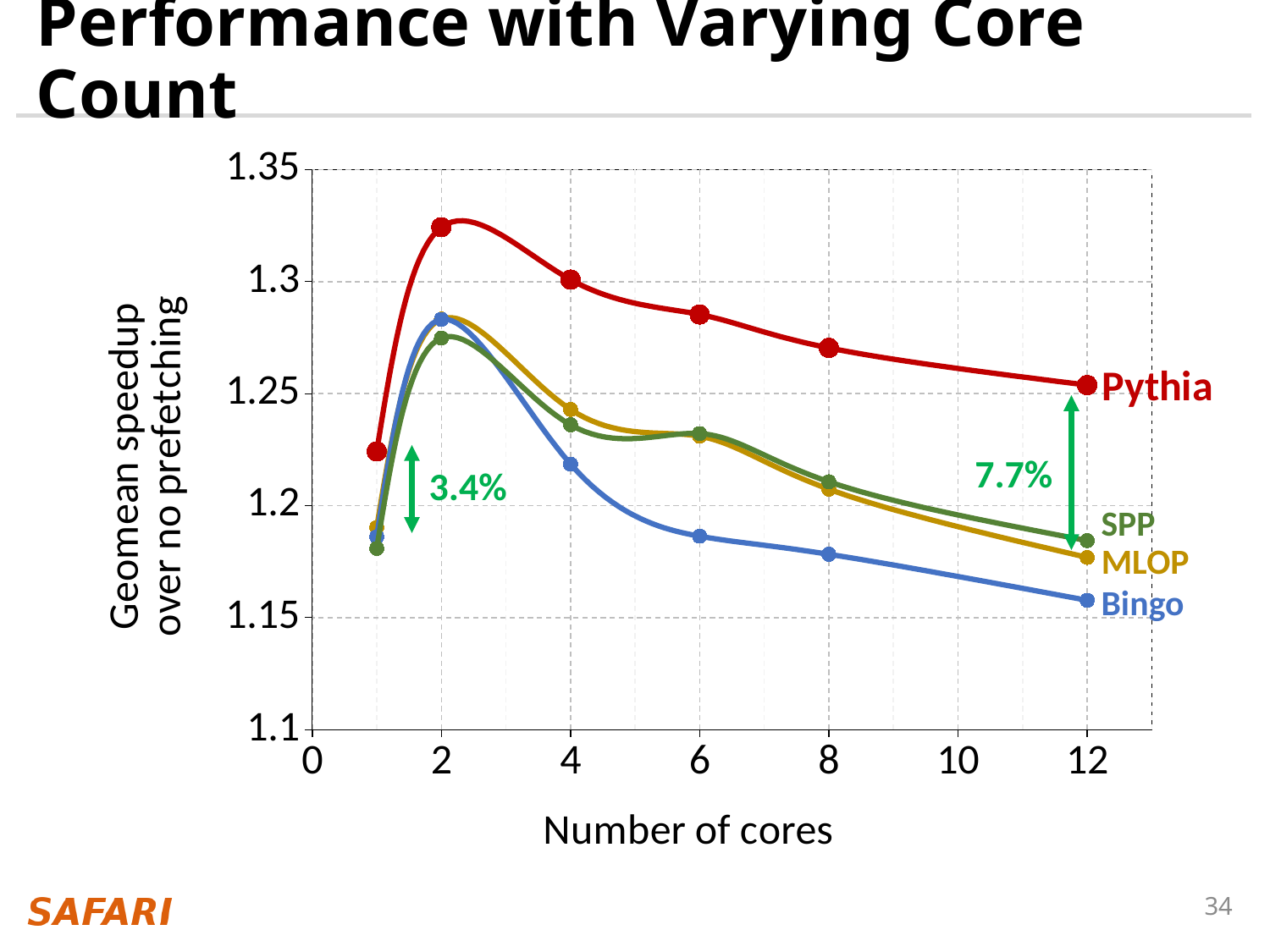
Is the geomean speedup for SPP at 2 cores greater or less than 1.25? greater Which prefetcher has the highest geomean speedup at 12 cores? Pythia How many series (prefetchers) are plotted in the chart? 4 Which prefetcher has the lowest geomean speedup at 12 cores? Bingo Which prefetcher has the lowest geomean speedup at 4 cores? Bingo Is the geomean speedup for Bingo at 12 cores greater or less than 1.2? less Is the geomean speedup for Pythia at 2 cores greater or less than 1.3? greater What kind of chart is shown on the slide? line chart At 8 cores, which has the higher geomean speedup, Pythia or MLOP? Pythia What is the label of the x axis? Number of cores How many data points does the Pythia line have? 6 Does the Pythia line rise or fall as the number of cores increases from 2 to 12? fall